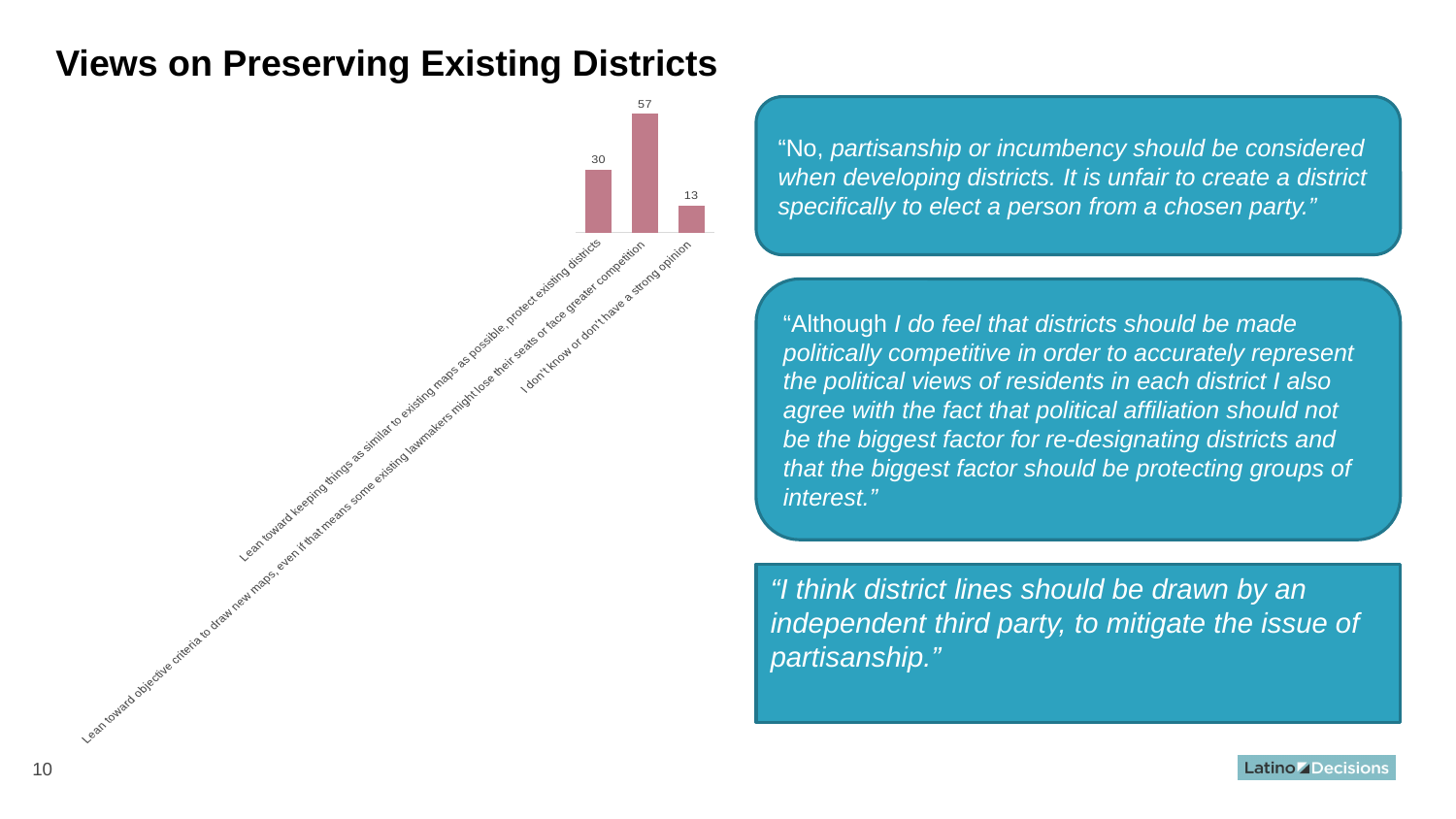
What is the sum of the three values shown in the chart? 100 What is the value for "I don't know or don't have a strong opinion"? 13 Which is larger: the value for leaning toward keeping things similar to existing maps or the value for "I don't know or don't have a strong opinion"? Lean toward keeping things as similar to existing maps as possible, protect existing districts Which category has the highest value? Lean toward objective criteria to draw new maps, even if that means some existing lawmakers might lose their seats or face greater competition What is the difference between the value for leaning toward keeping things similar to existing maps and the value for "I don't know or don't have a strong opinion"? 17 How many categories are shown in the chart? 3 What is the title of the slide containing the chart? Views on Preserving Existing Districts What kind of chart is shown on the slide? Bar chart Which category has the lowest value? I don't know or don't have a strong opinion What is the difference between the value for leaning toward objective criteria to draw new maps and the value for leaning toward keeping things similar to existing maps? 27 What is the value for "Lean toward keeping things as similar to existing maps as possible, protect existing districts"? 30 What is the value for "Lean toward objective criteria to draw new maps, even if that means some existing lawmakers might lose their seats or face greater competition"? 57